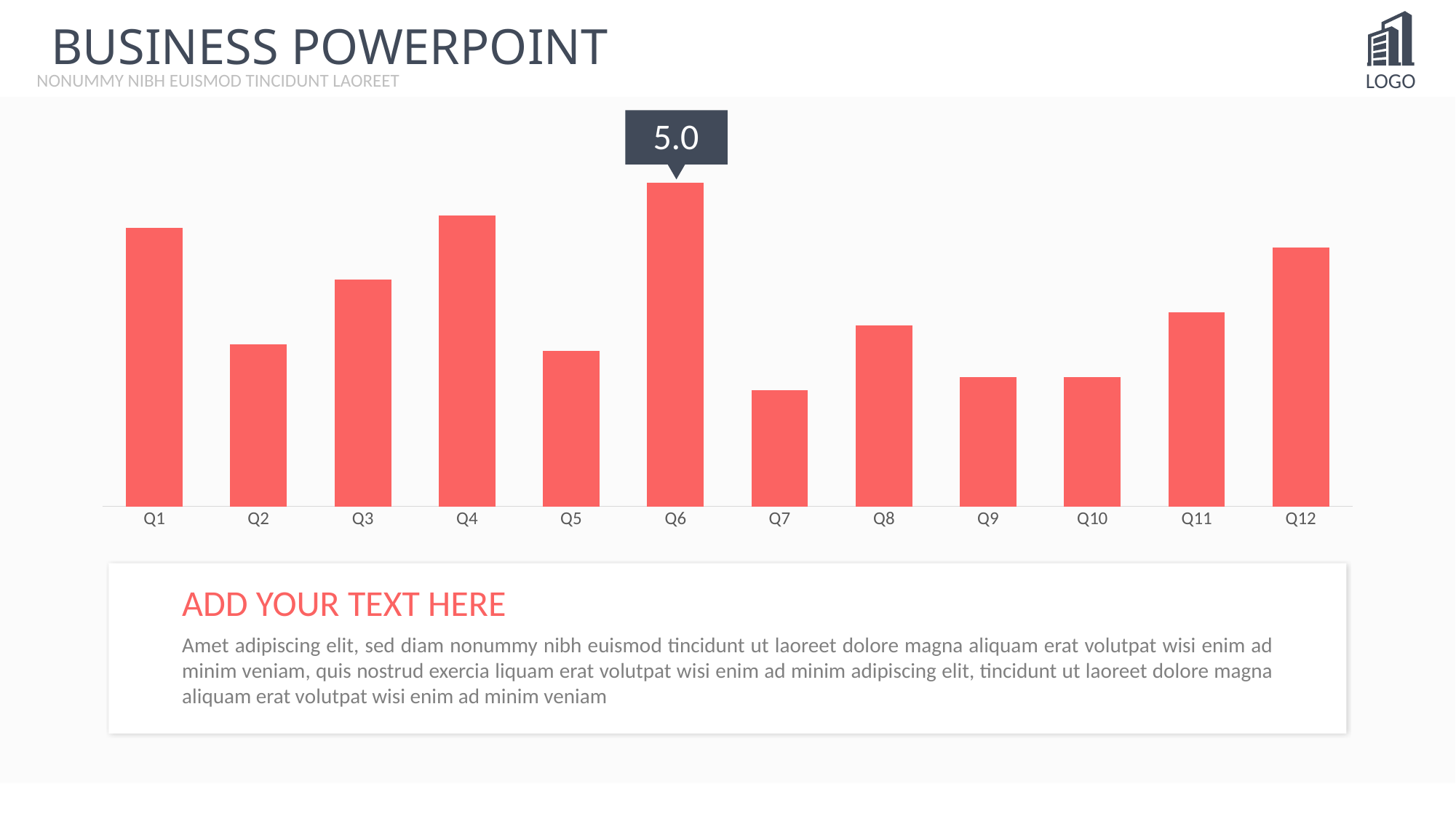
Which category's bar carries the only data label on the chart? Q6 Which is larger, the value for Q1 or the value for Q2? Q1 What kind of chart is shown on the slide? bar chart Which is larger, the value for Q4 or the value for Q3? Q4 Which category has the lowest bar? Q7 Which is larger, the value for Q8 or the value for Q7? Q8 How many categories are plotted on the chart? 12 Which category has the highest bar? Q6 What is the value shown for Q6? 5.0 What colour are the bars in the chart? red